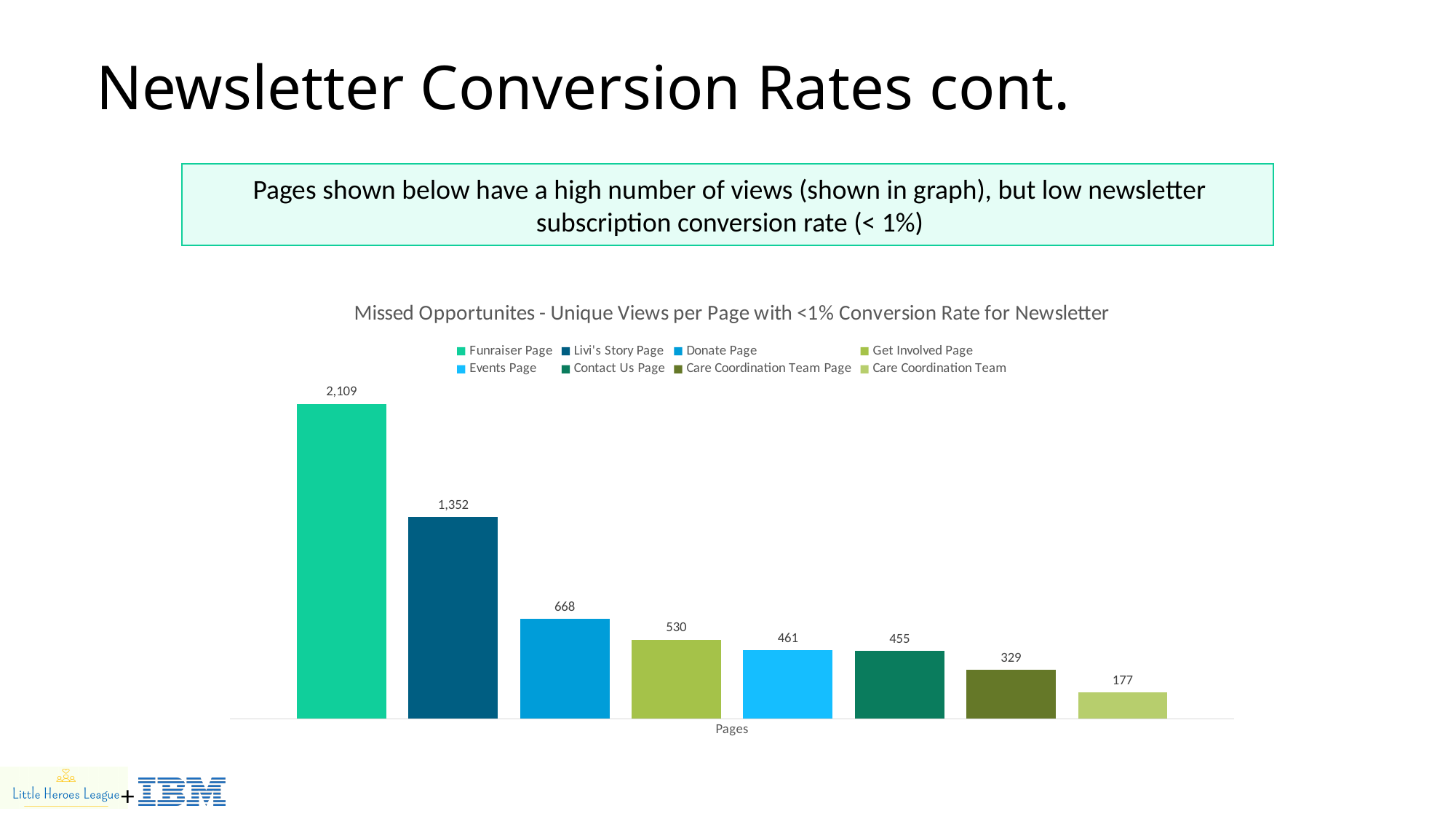
What is the difference between the Funraiser Page and Livi's Story Page values? 757 Which page has the lowest number of unique views? Care Coordination Team What is the value for the Donate Page? 668 Which has a larger value, the Get Involved Page or the Events Page? Get Involved Page What is the value for Livi's Story Page? 1,352 What is the value for the Care Coordination Team Page? 329 What is the title of the chart? Missed Opportunites - Unique Views per Page with <1% Conversion Rate for Newsletter How many series does the chart legend list? 8 What type of chart is shown on the slide? Bar chart What is the value for the Funraiser Page? 2,109 Which page has the highest number of unique views? Funraiser Page How many bars are plotted in the chart? 8